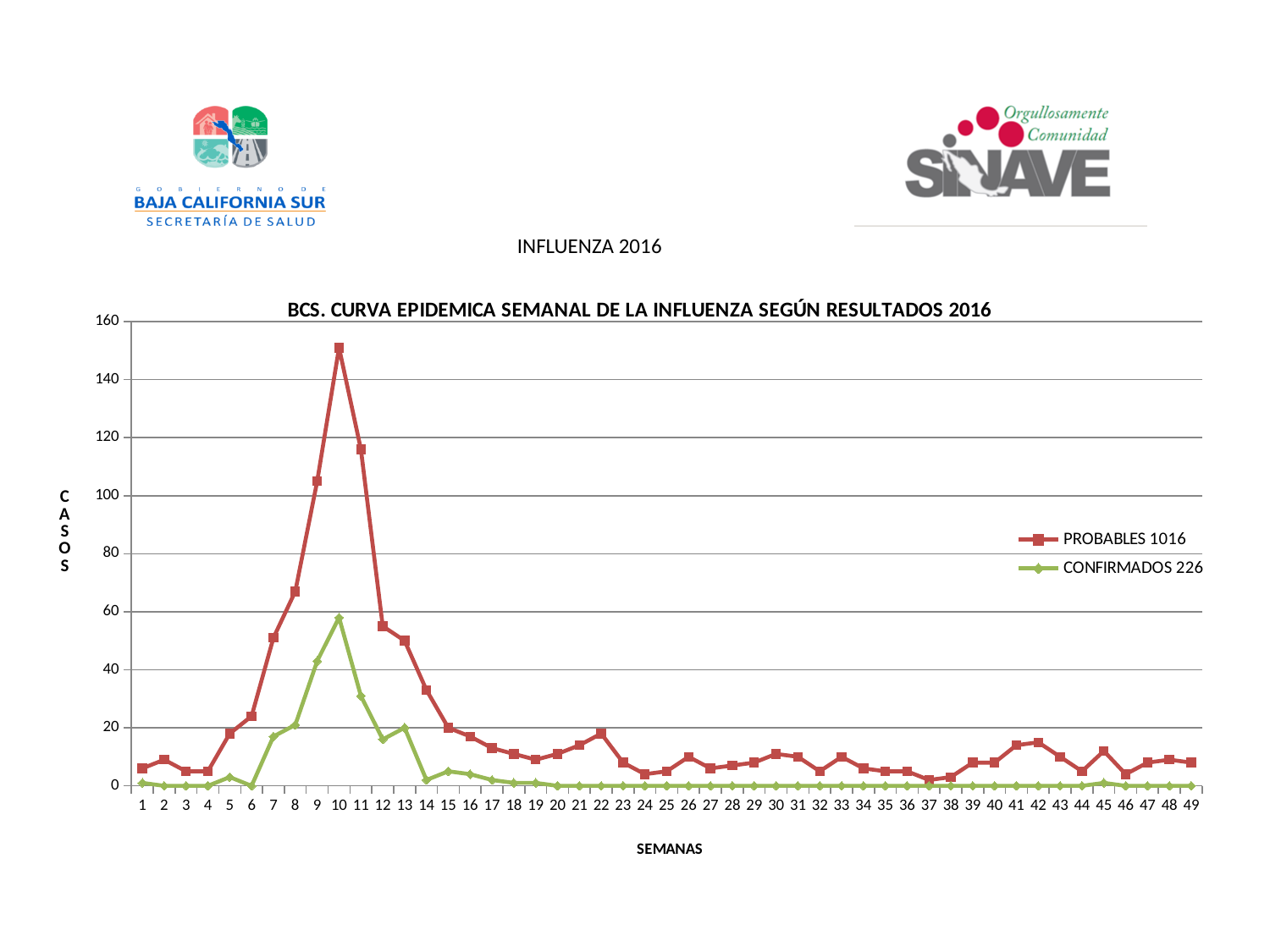
What kind of chart is shown on the slide? Line chart Which is larger in week 9: PROBABLES 1016 or CONFIRMADOS 226? PROBABLES 1016 Is the value for PROBABLES 1016 in week 1 greater or less than 20? less Is the value for CONFIRMADOS 226 in week 10 greater or less than 40? greater In which week does the PROBABLES 1016 series reach its highest value? 10 Do the PROBABLES 1016 values rise or fall from week 10 to week 15? fall How many series does the legend list? 2 In which week does the CONFIRMADOS 226 series reach its highest value? 10 How many weeks are plotted along the x axis? 49 Is the value for PROBABLES 1016 in week 10 greater or less than 140? greater What is the title of the chart? BCS. CURVA EPIDEMICA SEMANAL DE LA INFLUENZA SEGÚN RESULTADOS 2016